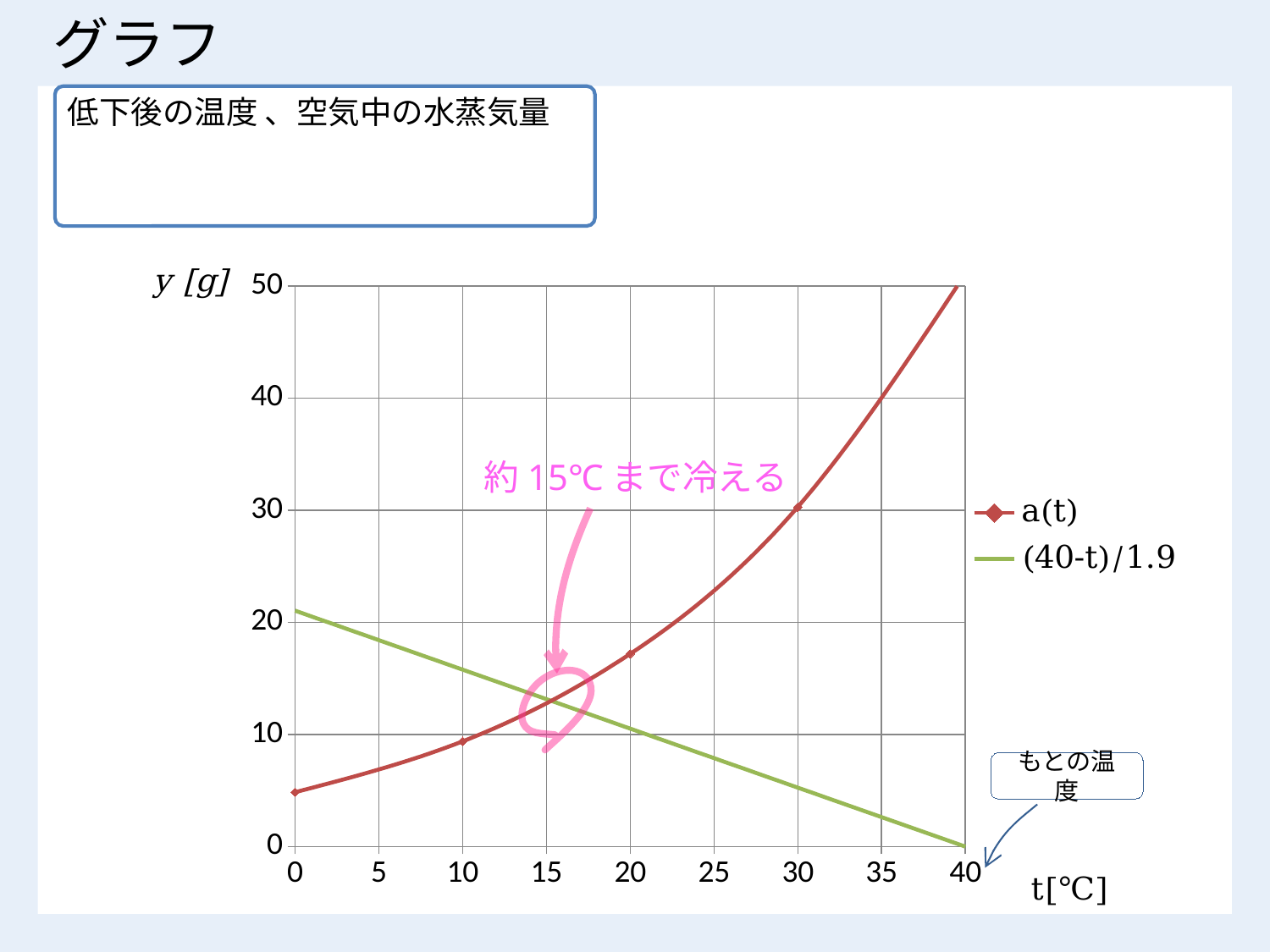
At t = 0, which series has the higher value, a(t) or (40-t)/1.9? (40-t)/1.9 What kind of chart is shown on the slide? line chart Does the a(t) series rise or fall as t increases from 0 to 40? rise Is the value of (40-t)/1.9 at t = 30 greater or less than 10? less Is the value of a(t) at t = 30 greater or less than 20? greater Is the value of (40-t)/1.9 at t = 20 greater or less than 20? less Does the (40-t)/1.9 series rise or fall as t increases from 0 to 40? fall How many series does the legend list? 2 What is the value of the (40-t)/1.9 series at t = 40? 0 What are the two series named in the legend? a(t) and (40-t)/1.9 At t = 30, which series has the higher value, a(t) or (40-t)/1.9? a(t)